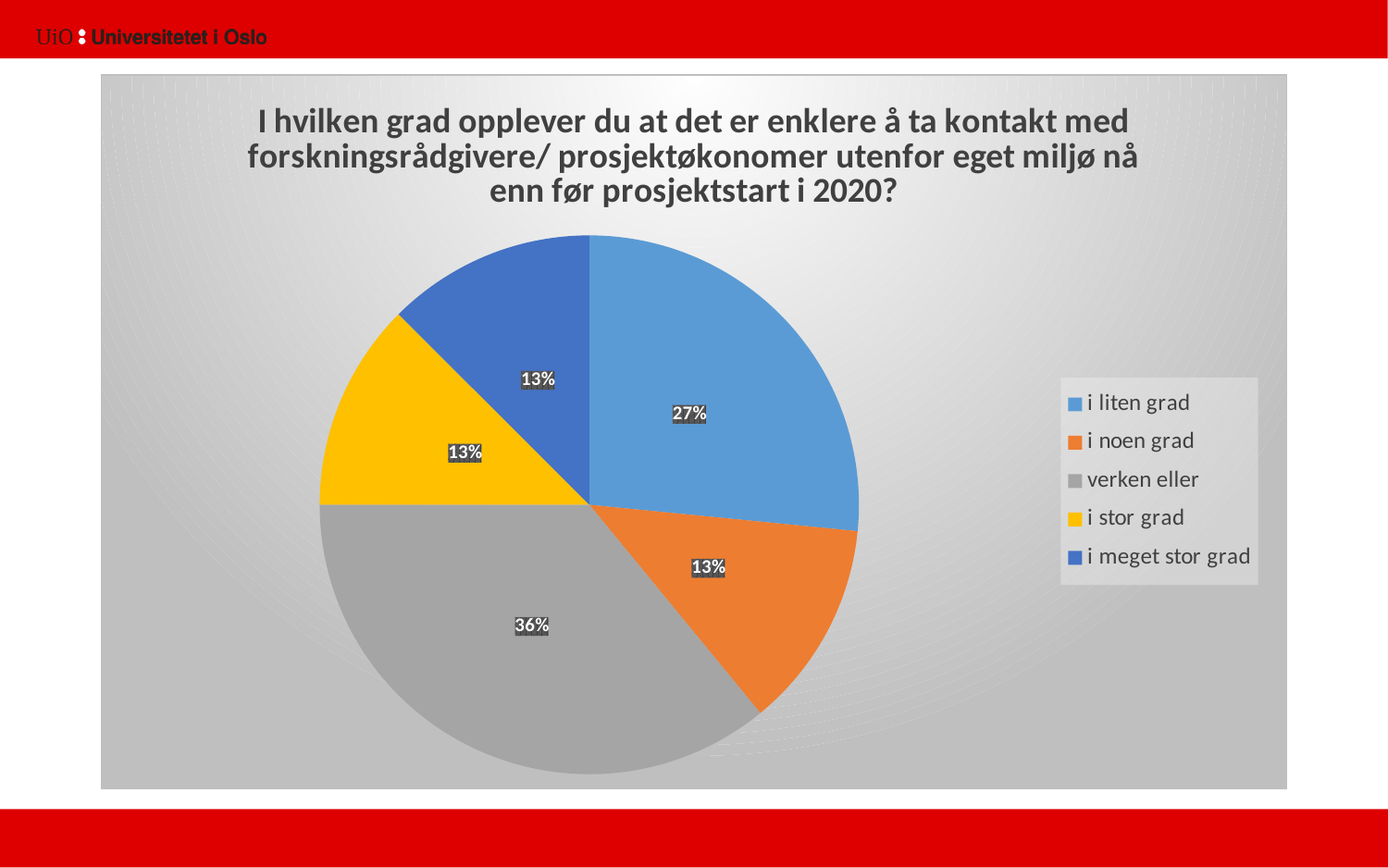
What share of the pie does "i liten grad" have? 27% How many categories does the legend list? 5 What share of the pie does "i noen grad" have? 13% What share of the pie does "verken eller" have? 36% Which is larger, the slice for "i liten grad" or the slice for "i noen grad"? i liten grad What is the difference in percentage points between "verken eller" and "i liten grad"? 9 What is the combined share of "i stor grad" and "i meget stor grad"? 26% Which category has the largest slice of the pie? verken eller What kind of chart is shown on the slide? pie chart What colour is the slice for "i stor grad"? yellow